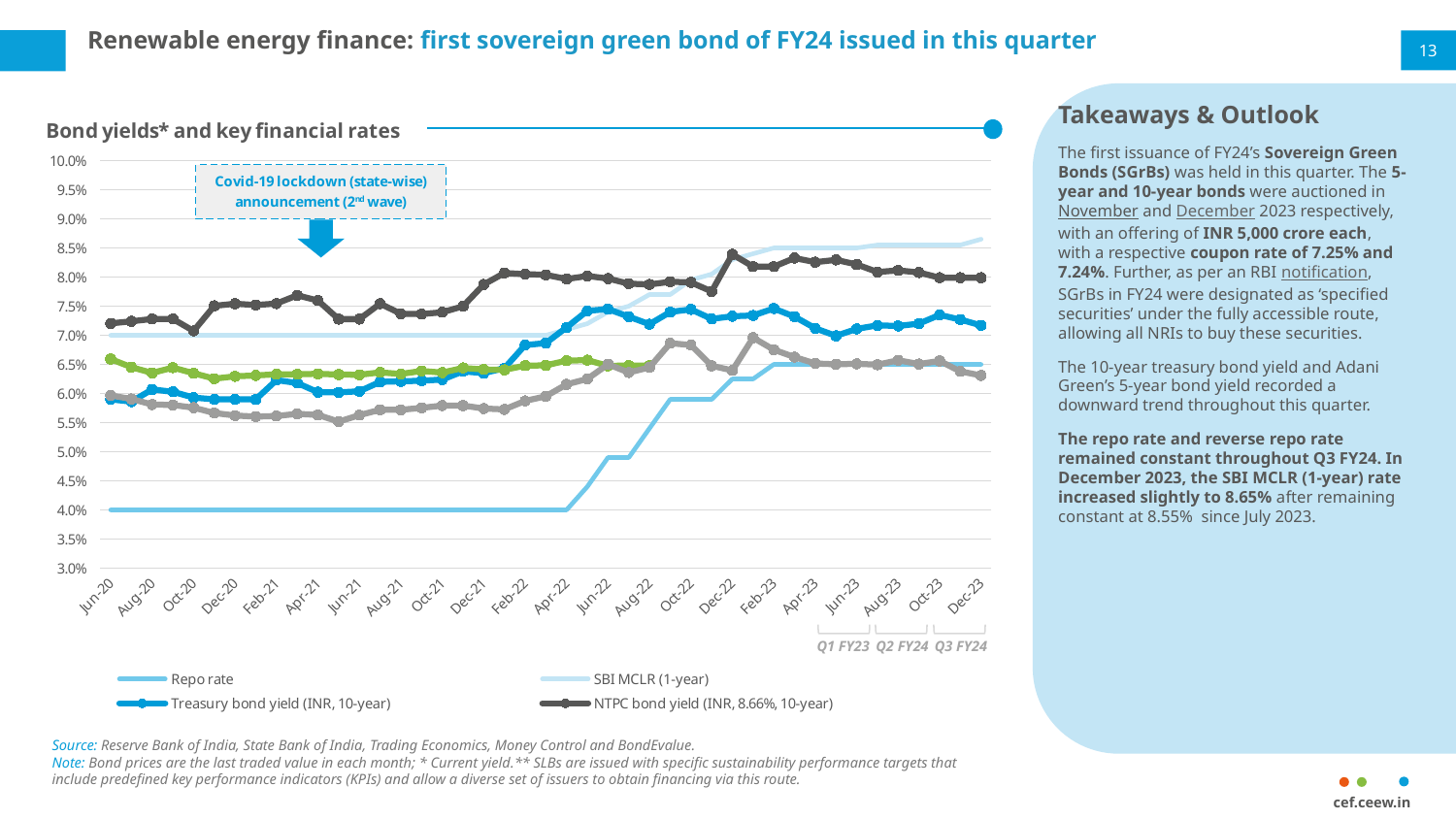
Which legend series has the lowest value in Jun-20? Repo rate Is the NTPC bond yield (INR, 8.66%, 10-year) in Dec-22 greater or less than 8.0%? greater What kind of chart is 'Bond yields* and key financial rates'? line chart In Dec-23, which is higher: the NTPC bond yield (INR, 8.66%, 10-year) or the Treasury bond yield (INR, 10-year)? NTPC bond yield (INR, 8.66%, 10-year) How many series does the legend of the 'Bond yields* and key financial rates' chart list? 4 Is the SBI MCLR (1-year) in Dec-23 greater or less than 8.5%? greater What event does the annotation box with the arrow on the chart refer to? Covid-19 lockdown (state-wise) announcement (2nd wave) What is the title of the chart on the slide? Bond yields* and key financial rates What is the repo rate value shown for Jun-20? 4.0% What is the repo rate value shown for Dec-23? 6.5% Does the repo rate rise or fall between Jun-20 and Dec-23? rise